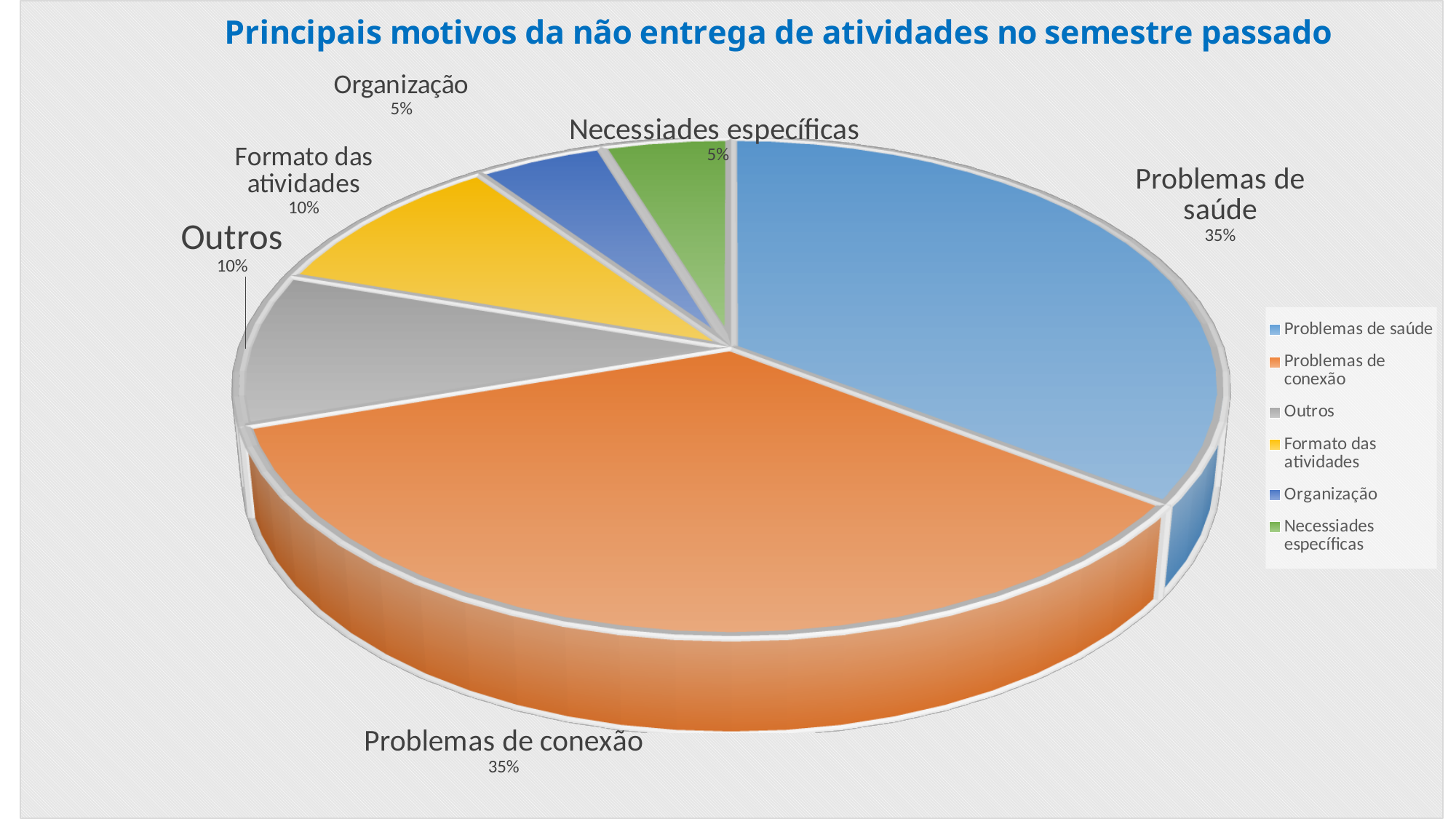
What is the value for Formato das atividades? 10% What share of the pie does Necessiades específicas represent? 5% What kind of chart is shown on the slide? Pie chart What share of the pie does Problemas de saúde represent? 35% What percentage is shown for Organização? 5% What percentage is shown for Outros? 10% Which is larger, the slice for Problemas de saúde or the slice for Formato das atividades? Problemas de saúde How many categories (slices) does the pie chart have? 6 Which is larger, the slice for Outros or the slice for Organização? Outros What is the difference between the value for Problemas de conexão and the value for Outros? 25% What is the title of the chart? Principais motivos da não entrega de atividades no semestre passado What is the value shown for Problemas de conexão? 35%